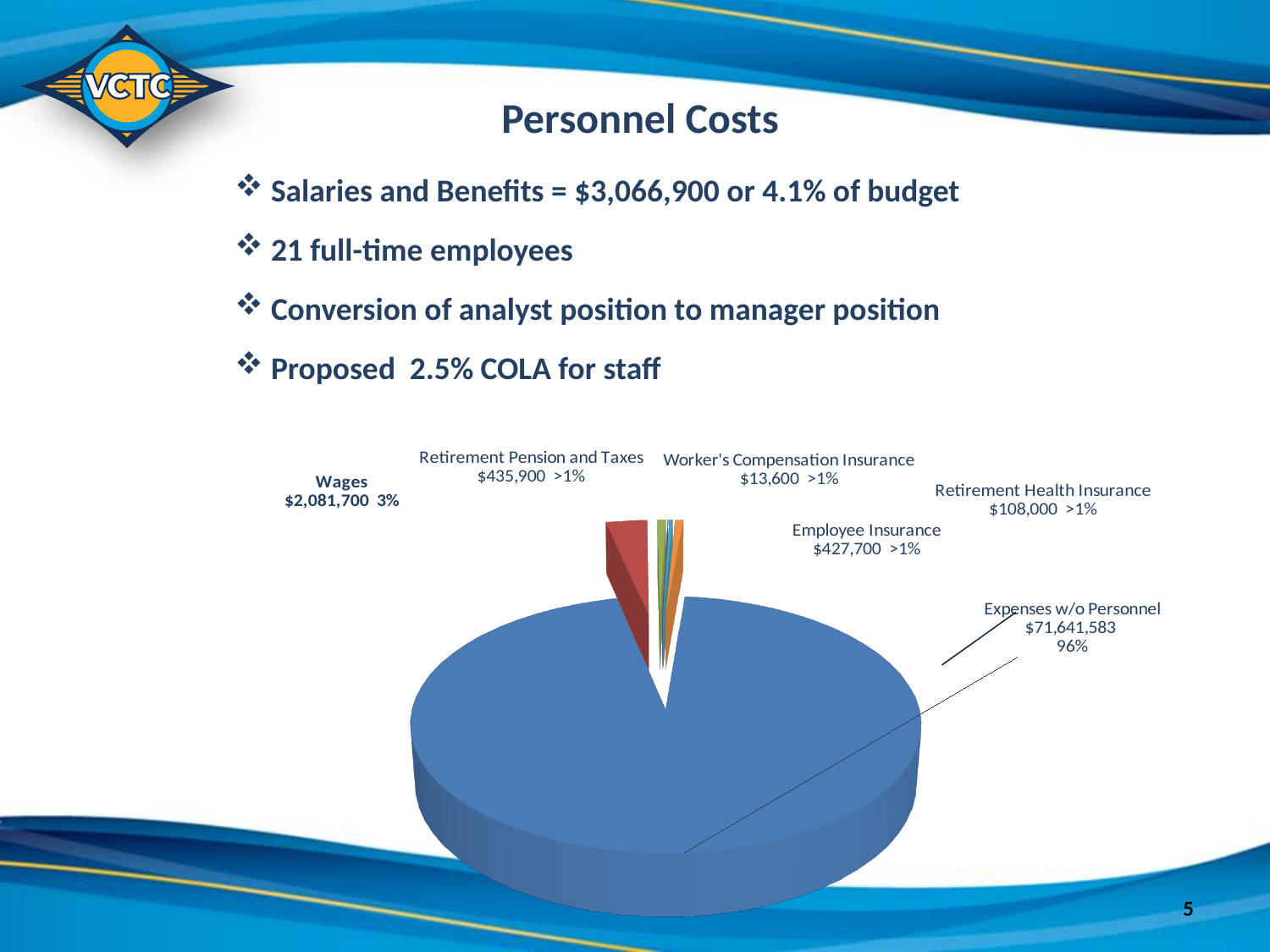
What type of chart is shown on the slide? Pie chart Which category has the smallest value in the pie chart? Worker's Compensation Insurance What is the value shown for Retirement Pension and Taxes? $435,900 Which category has the largest slice of the pie chart? Expenses w/o Personnel What is the value shown for Wages in the pie chart? $2,081,700 What share of the pie does Expenses w/o Personnel represent? 96% How many slices does the pie chart have? 6 Which is larger, the value for Employee Insurance or the value for Retirement Health Insurance? Employee Insurance What is the difference between the Wages value and the Retirement Pension and Taxes value? $1,645,800 What is the value shown for Expenses w/o Personnel? $71,641,583 What share of the pie does Wages represent? 3% What is the value shown for Worker's Compensation Insurance? $13,600